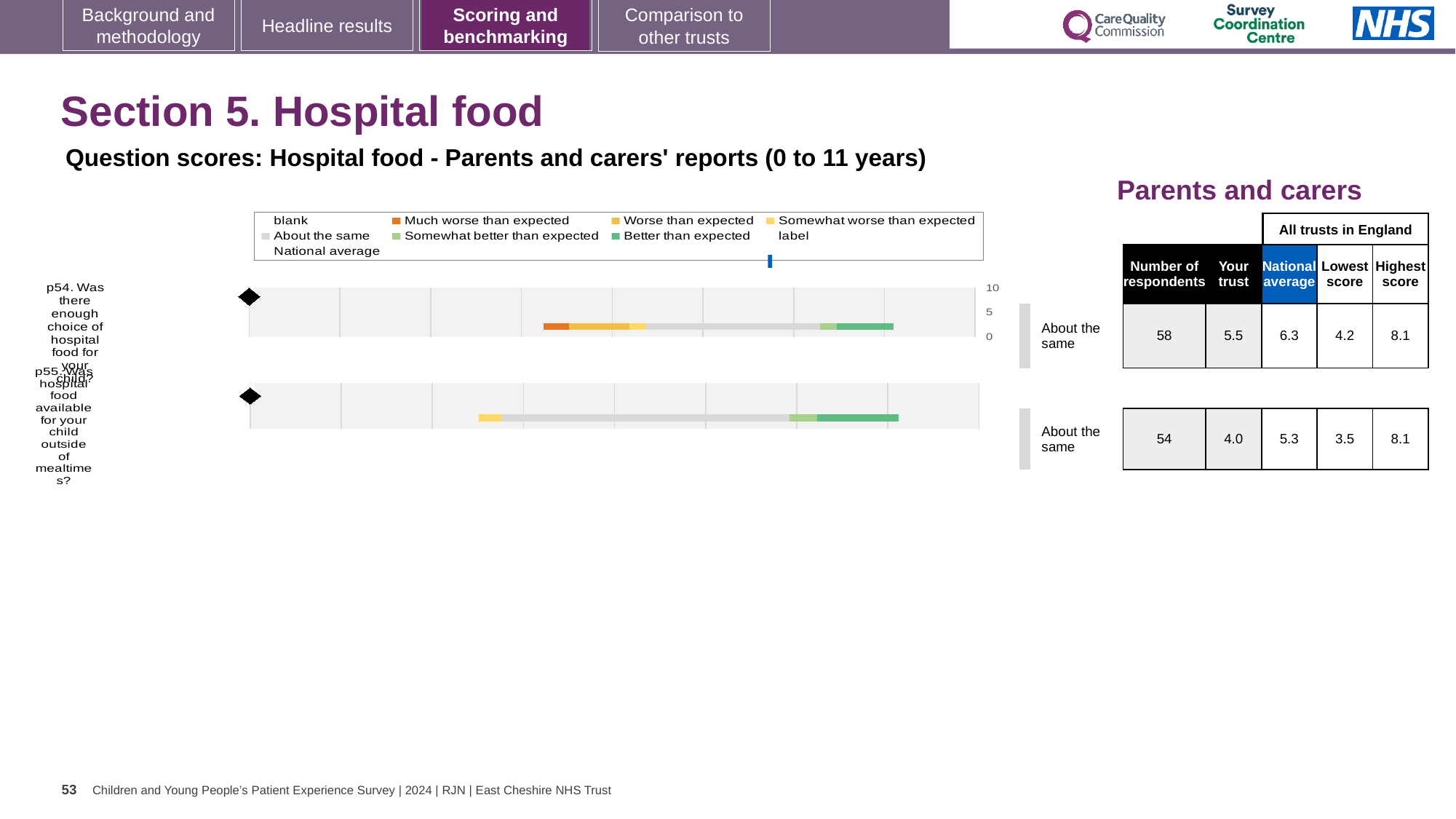
In the table next to the chart, what is the lowest score across all trusts in England for p55? 3.5 What kind of chart is shown on the slide? bar chart In the table next to the chart, how many respondents answered p54? 58 What is the highest value shown on the chart's axis? 10 In the table next to the chart, what is the national average for p55 (hospital food available outside of mealtimes)? 5.3 What benchmark category is shown for both p54 and p55? About the same In the table next to the chart, what is the 'Your trust' score for p54 (enough choice of hospital food)? 5.5 How many entries does the chart legend list? 9 In the table next to the chart, which question has the higher 'Your trust' score, p54 or p55? p54 In the table next to the chart, what is the difference between the national average and the trust score for p54? 0.8 Which colour does the legend use for 'Much worse than expected'? orange How many questions (categories) are plotted in the chart? 2